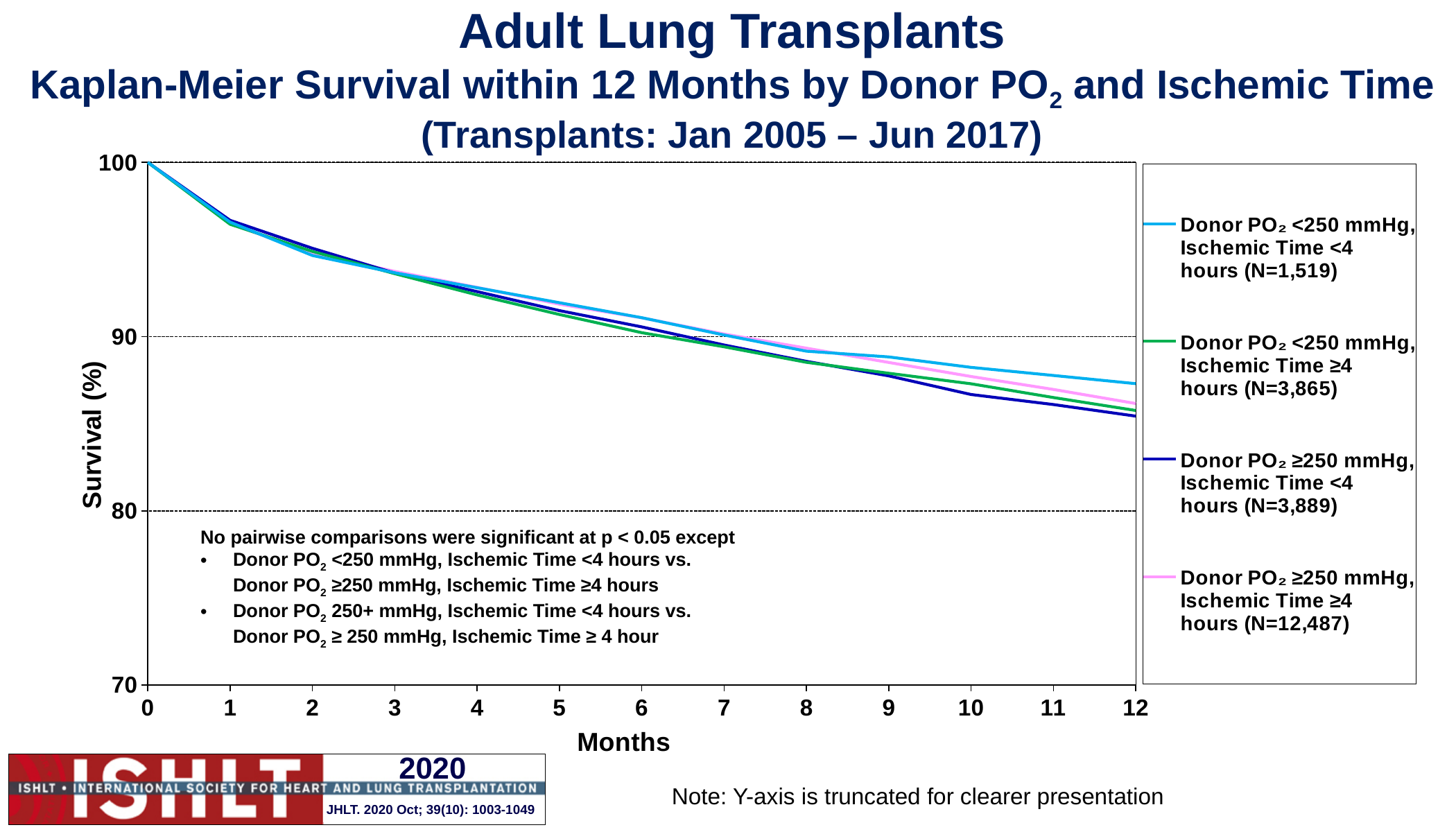
At 12 months, is survival for Donor PO₂ ≥250 mmHg, Ischemic Time <4 hours greater or less than 90? less How many series does the legend list? 4 What is the N for the Donor PO₂ ≥250 mmHg, Ischemic Time ≥4 hours group in the legend? 12,487 At 3 months, is survival for Donor PO₂ <250 mmHg, Ischemic Time ≥4 hours greater or less than 90? greater What is the survival value for all groups at month 0? 100 Do the survival curves rise or fall as months increase? fall Which group has the highest survival at 12 months? Donor PO₂ <250 mmHg, Ischemic Time <4 hours (N=1,519) How many month ticks are labeled on the x axis? 13 At 12 months, is survival for Donor PO₂ <250 mmHg, Ischemic Time <4 hours greater or less than 80? greater At 12 months, which is larger: survival for Donor PO₂ <250 mmHg, Ischemic Time <4 hours or for Donor PO₂ ≥250 mmHg, Ischemic Time <4 hours? Donor PO₂ <250 mmHg, Ischemic Time <4 hours What kind of chart is shown on the slide? line chart What is the label of the y axis? Survival (%)